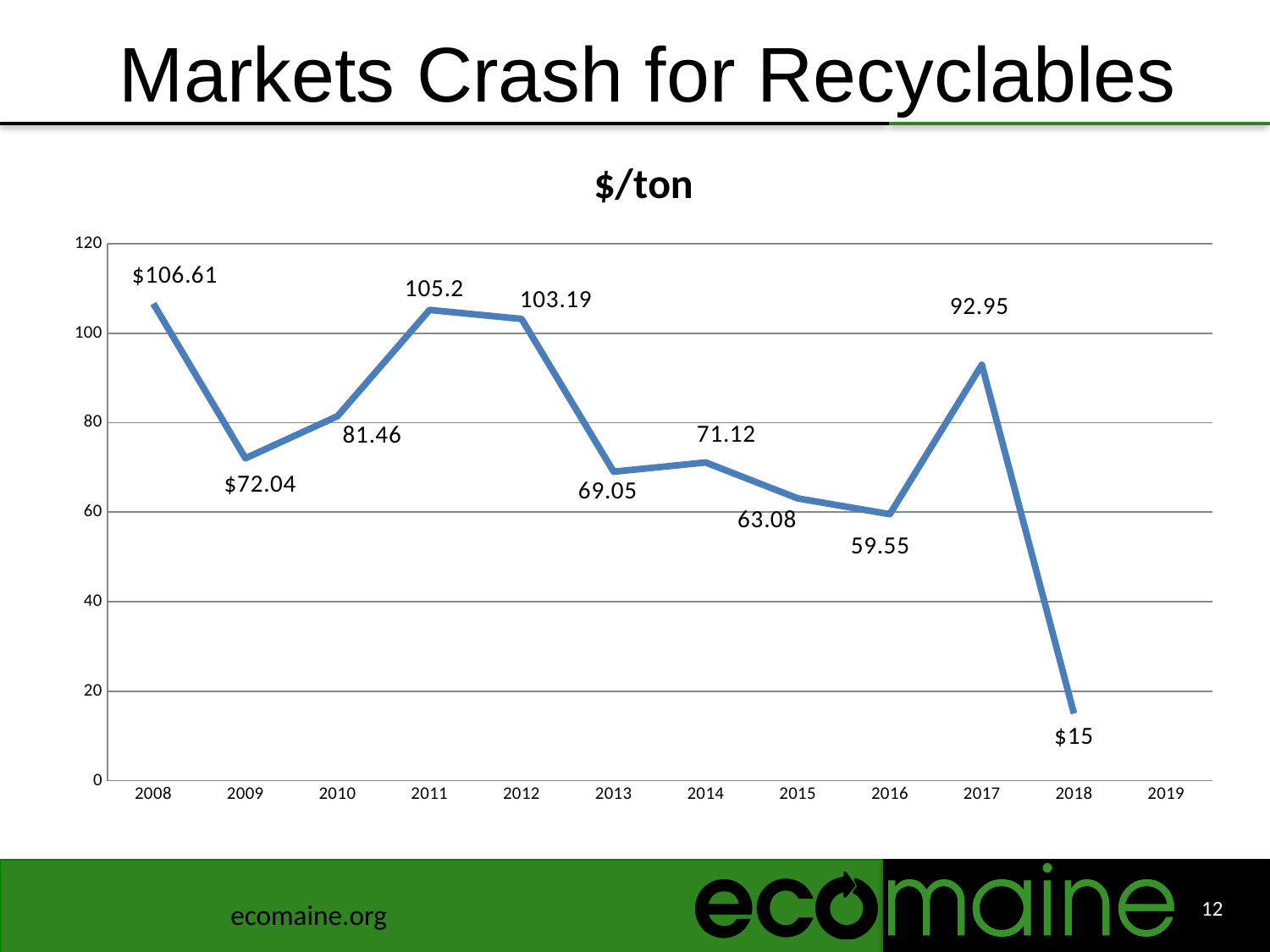
Does the value rise or fall from 2017 to 2018? fall What is the value for 2011? 105.2 Is the value for 2017 greater or less than 80? greater What is the title of the chart? $/ton What is the value for 2016? 59.55 What is the difference between the values for 2017 and 2018? 77.95 What kind of chart is shown? line chart What is the value for 2008? $106.61 Which year has the highest value? 2008 Which is larger, the value for 2013 or the value for 2014? 2014 Which year has the lowest value? 2018 What is the value for 2018? $15